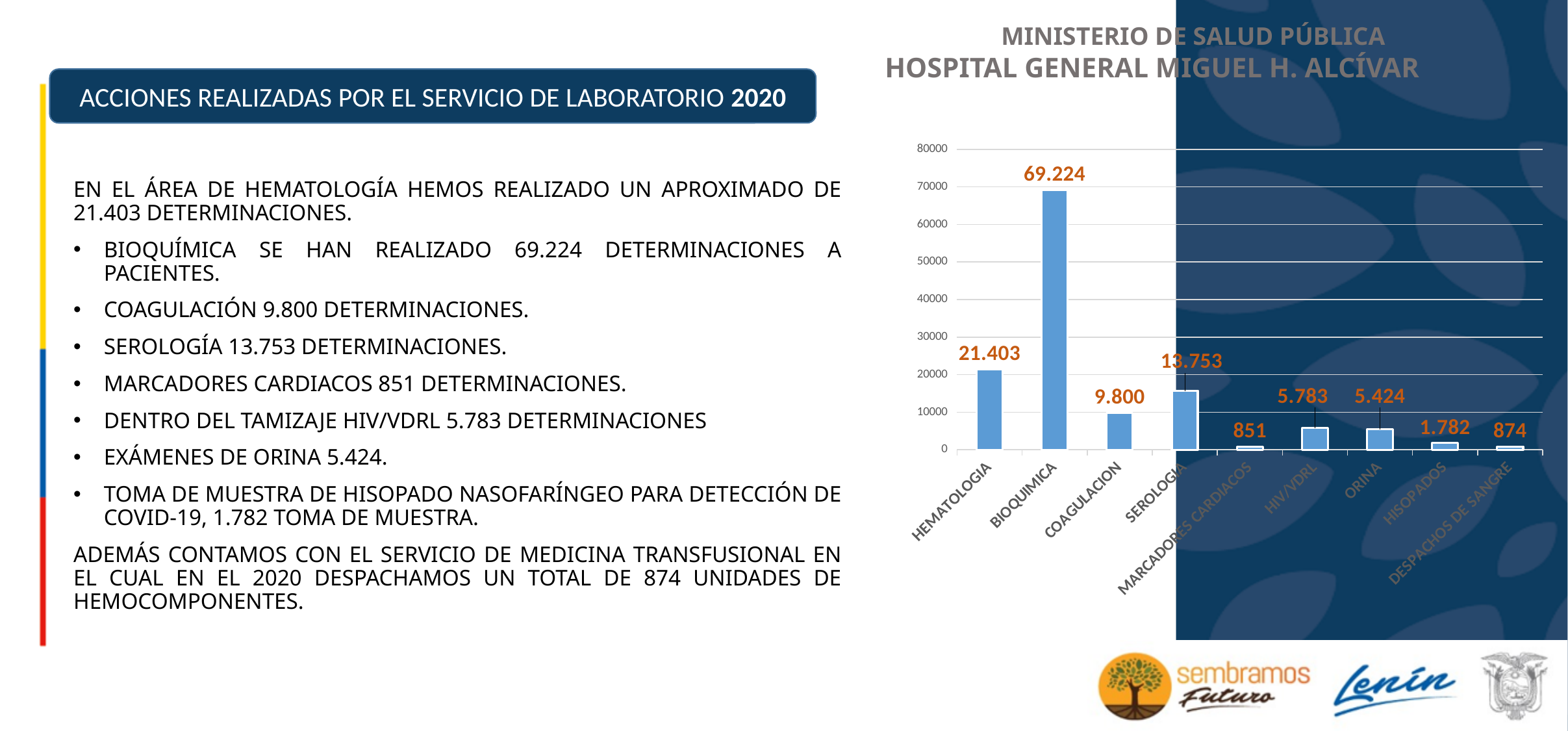
What kind of chart is shown on the slide? bar chart What is the value for DESPACHOS DE SANGRE? 874 What is the value for BIOQUIMICA? 69.224 Which category has the highest value? BIOQUIMICA What is the value for HISOPADOS? 1.782 Is the value for HEMATOLOGIA greater or less than 20000? greater Which category has the lowest value? MARCADORES CARDIACOS What is the difference between the values for BIOQUIMICA and HEMATOLOGIA? 47.821 How many categories are shown on the x axis? 9 What is the difference between the values for SEROLOGIA and COAGULACION? 3.953 What is the value for SEROLOGIA? 13.753 Which is larger, the value for HIV/VDRL or the value for ORINA? HIV/VDRL